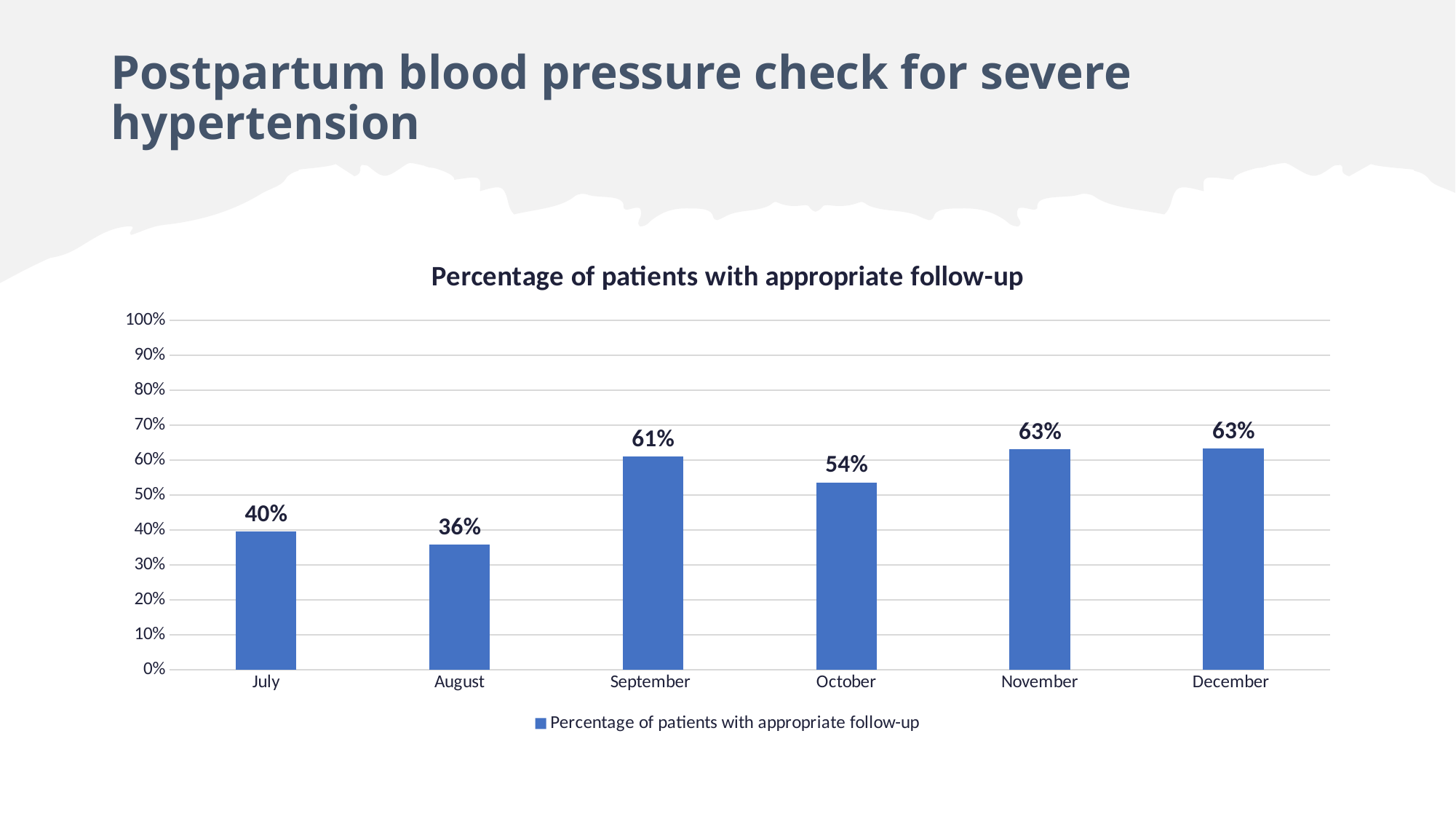
Is the value for December greater or less than 50%? greater What is the difference between the percentage for September and the percentage for July? 21% How many months are shown on the x axis of the chart? 6 Which month has the lowest percentage of patients with appropriate follow-up? August How many series does the legend list? 1 What kind of chart is shown on the slide? Bar chart What is the percentage of patients with appropriate follow-up in October? 54% What is the percentage of patients with appropriate follow-up in September? 61% Which is larger, the percentage for October or the percentage for July? October What is the percentage of patients with appropriate follow-up in August? 36% What is the difference between the percentage for November and the percentage for August? 27% What is the title of the chart? Percentage of patients with appropriate follow-up